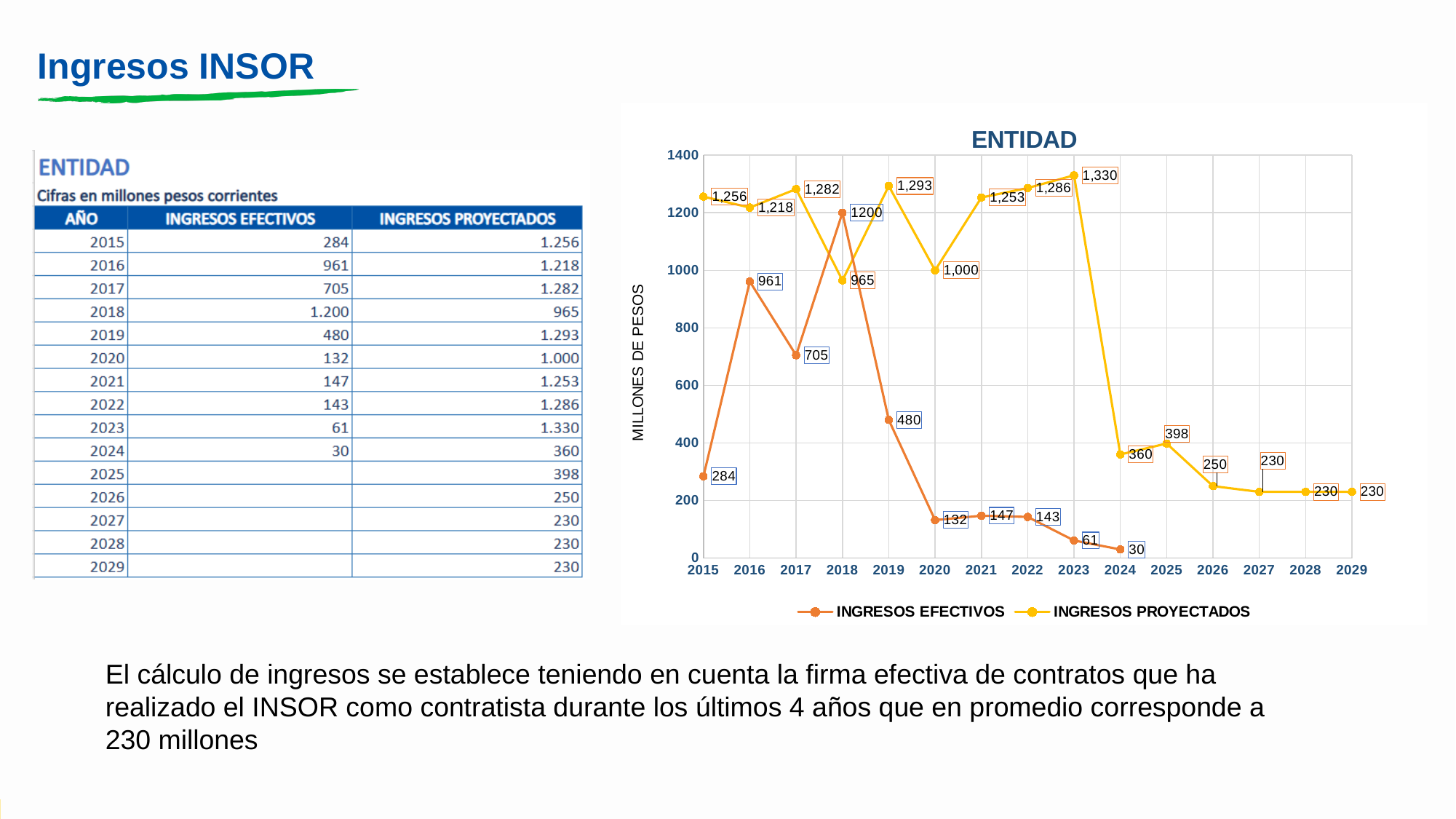
How many series does the chart legend list? 2 In which year is INGRESOS EFECTIVOS highest? 2018 What is the value of INGRESOS PROYECTADOS in 2023? 1,330 What type of chart is shown on the slide? line chart What is the difference between INGRESOS PROYECTADOS and INGRESOS EFECTIVOS in 2019? 813 Which is larger in 2018, INGRESOS EFECTIVOS or INGRESOS PROYECTADOS? INGRESOS EFECTIVOS How many years are shown on the x axis of the chart? 15 What is the value of INGRESOS PROYECTADOS in 2020? 1,000 In which year is INGRESOS PROYECTADOS highest? 2023 What is the title of the chart? ENTIDAD In which year is INGRESOS EFECTIVOS lowest? 2024 What is the value of INGRESOS EFECTIVOS in 2016? 961